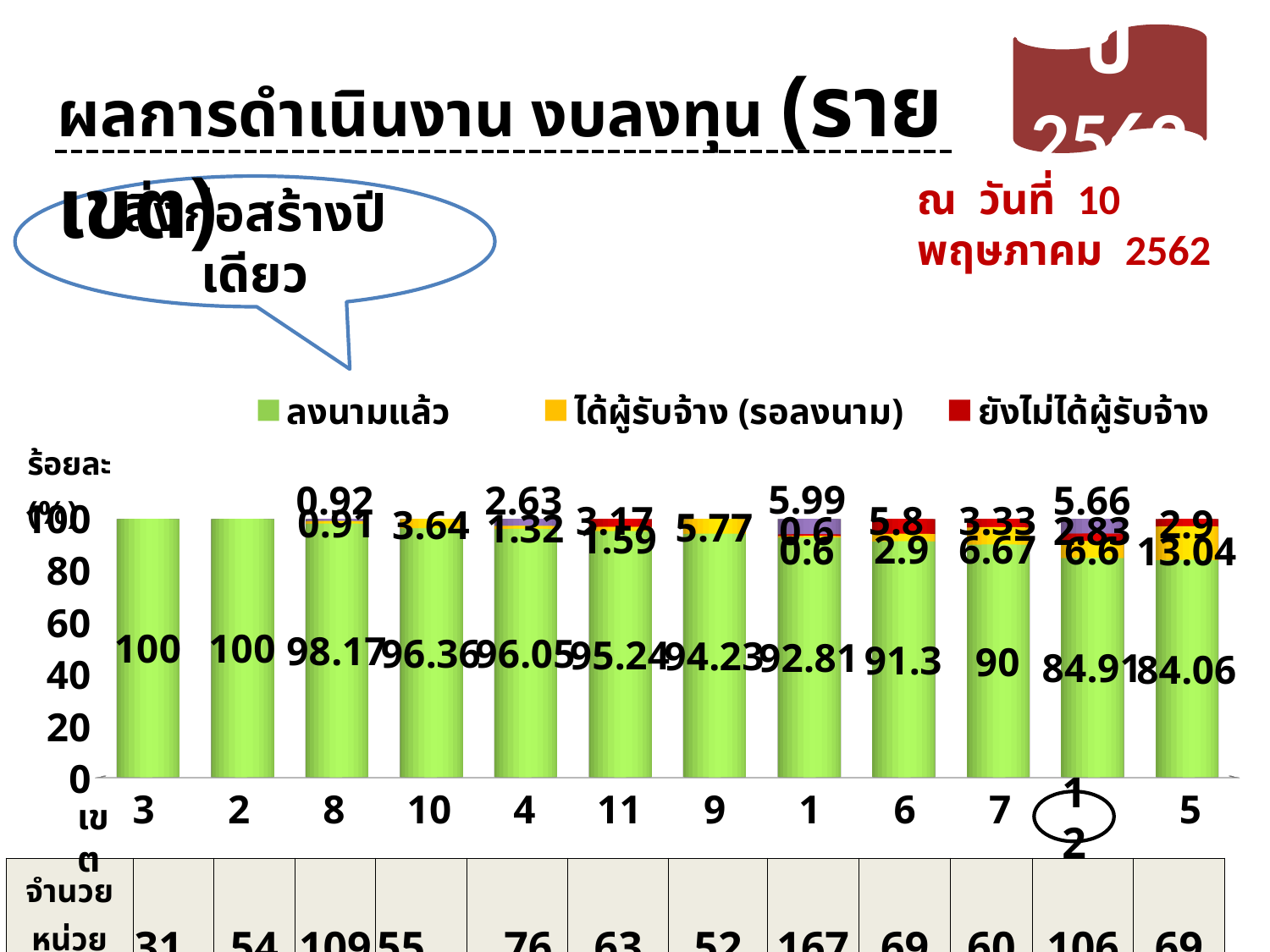
What is the ลงนามแล้ว value for เขต 8? 98.17 How many series does the chart legend list? 3 What type of chart is shown on the slide? bar chart How many เขต categories are plotted along the x axis? 12 Which has a higher ลงนามแล้ว value, เขต 8 or เขต 7? เขต 8 What is the ลงนามแล้ว value for เขต 1? 92.81 Do the ลงนามแล้ว values rise or fall from left to right along the x axis? fall What is the difference between the ลงนามแล้ว values for เขต 3 and เขต 5? 15.94 Which เขต has the lowest ลงนามแล้ว value? เขต 5 What is the ลงนามแล้ว value for เขต 5? 84.06 Is the ลงนามแล้ว value for เขต 12 greater or less than 80? greater Which series is listed first in the chart legend? ลงนามแล้ว